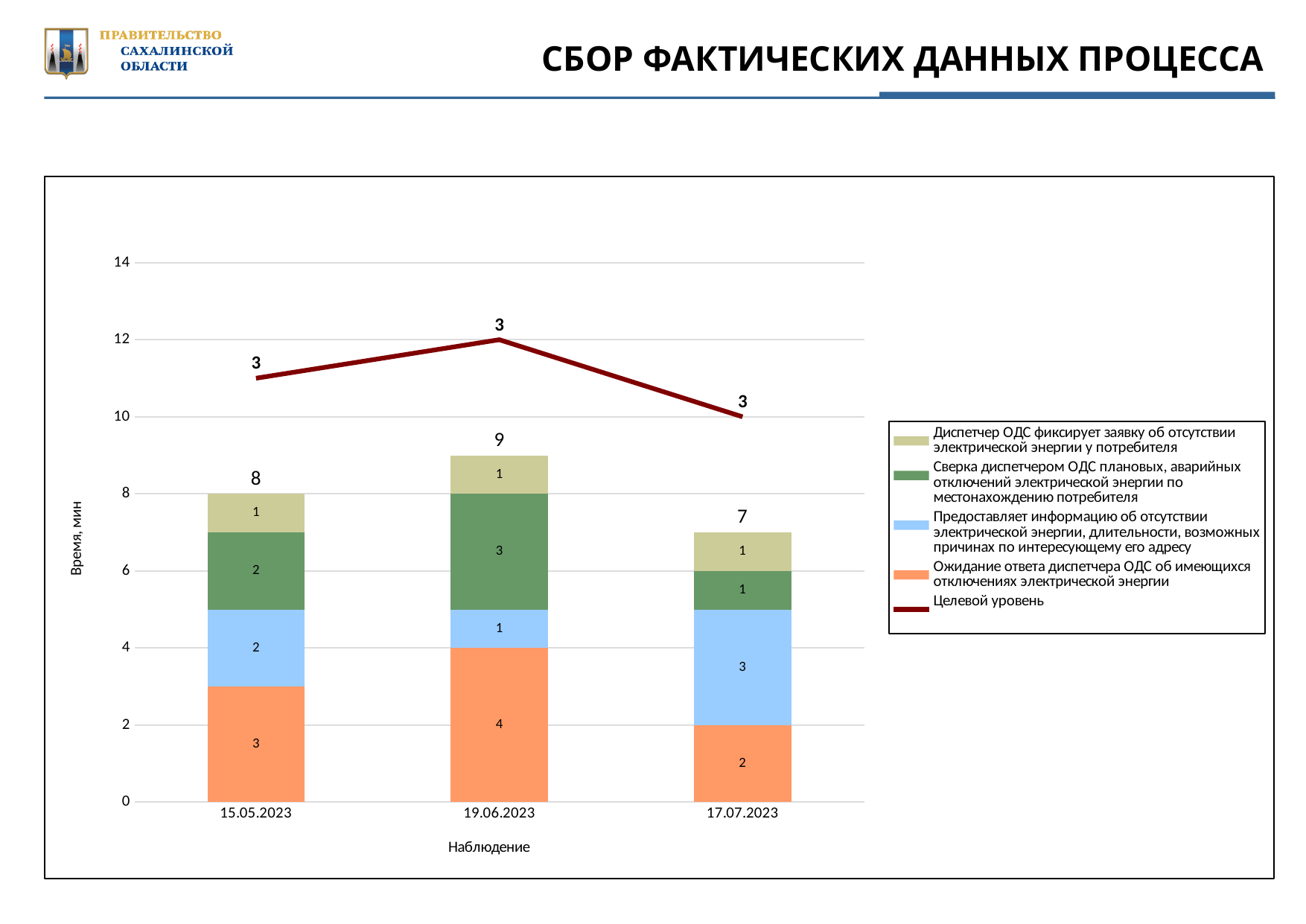
What is the value of the 'Ожидание ответа диспетчера ОДС об имеющихся отключениях электрической энергии' segment for 15.05.2023? 3 What is the label of the y axis? Время, мин How many entries does the legend list? 5 What is the value of the 'Предоставляет информацию об отсутствии электрической энергии, длительности, возможных причинах по интересующему его адресу' segment for 17.07.2023? 3 Which is larger: the 'Ожидание ответа диспетчера ОДС' segment for 19.06.2023 or for 17.07.2023? 19.06.2023 Which observation date has the lowest stacked bar total? 17.07.2023 What is the total of the stacked bar for 19.06.2023? 9 What is the value of the 'Сверка диспетчером ОДС плановых, аварийных отключений электрической энергии по местонахождению потребителя' segment for 19.06.2023? 3 What is the total of the stacked bar for 17.07.2023? 7 What is the difference between the stacked bar totals for 19.06.2023 and 17.07.2023? 2 How many observation dates are shown on the x axis? 3 Which observation date has the highest stacked bar total? 19.06.2023